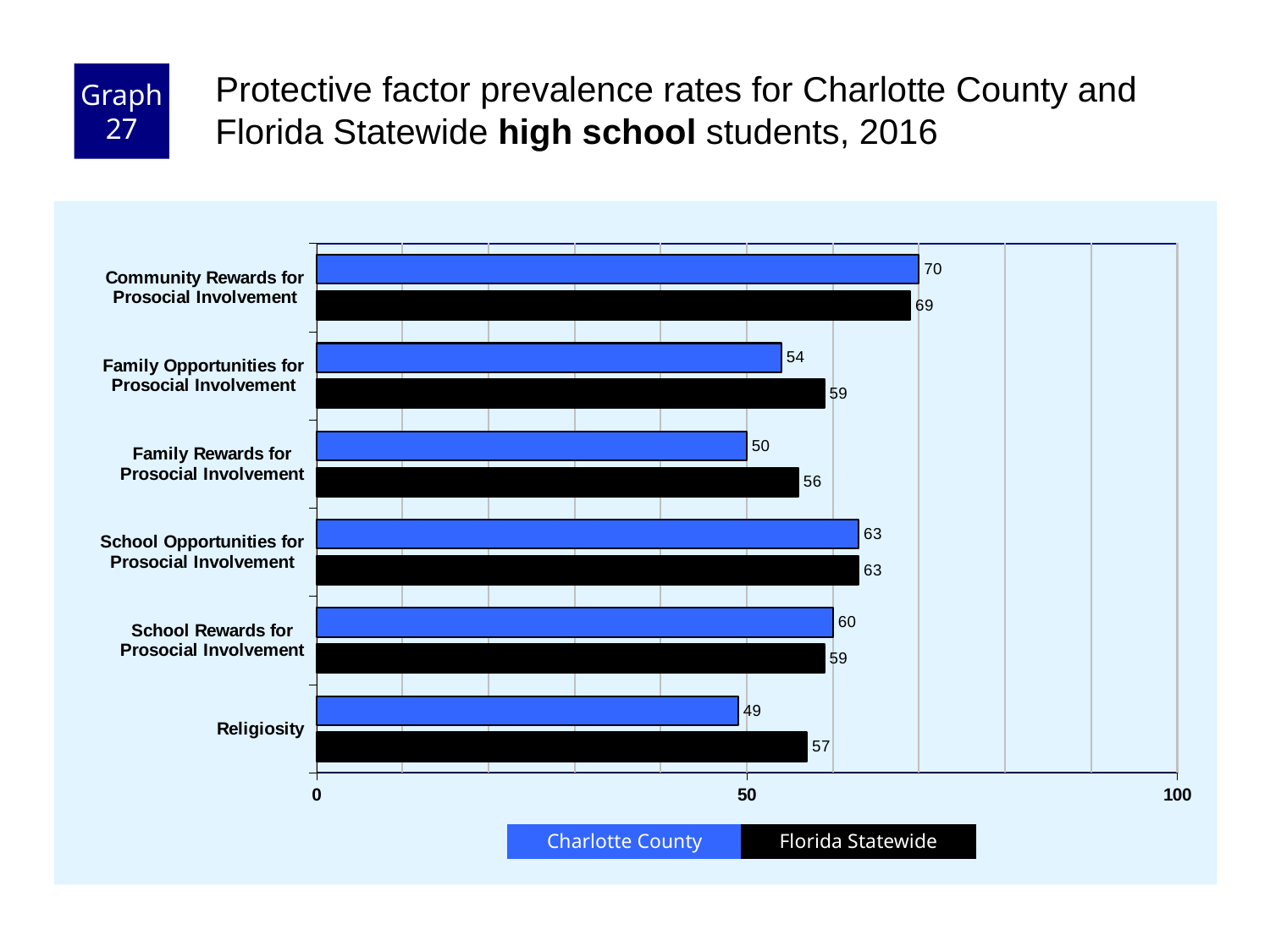
Is the Charlotte County value for Family Rewards for Prosocial Involvement greater or less than 50? neither, it equals 50 What is the difference between the Florida Statewide and Charlotte County values for Religiosity? 8 Which category has the highest Charlotte County value? Community Rewards for Prosocial Involvement What is the difference between the Florida Statewide and Charlotte County values for Family Opportunities for Prosocial Involvement? 5 How many series does the legend list? 2 What is the Florida Statewide value for Family Rewards for Prosocial Involvement? 56 What kind of chart is shown on the slide? bar chart What is the Florida Statewide value for Religiosity? 57 Which category has the lowest Charlotte County value? Religiosity For School Rewards for Prosocial Involvement, which is larger: Charlotte County or Florida Statewide? Charlotte County How many categories are shown on the chart? 6 What is the Charlotte County value for Community Rewards for Prosocial Involvement? 70